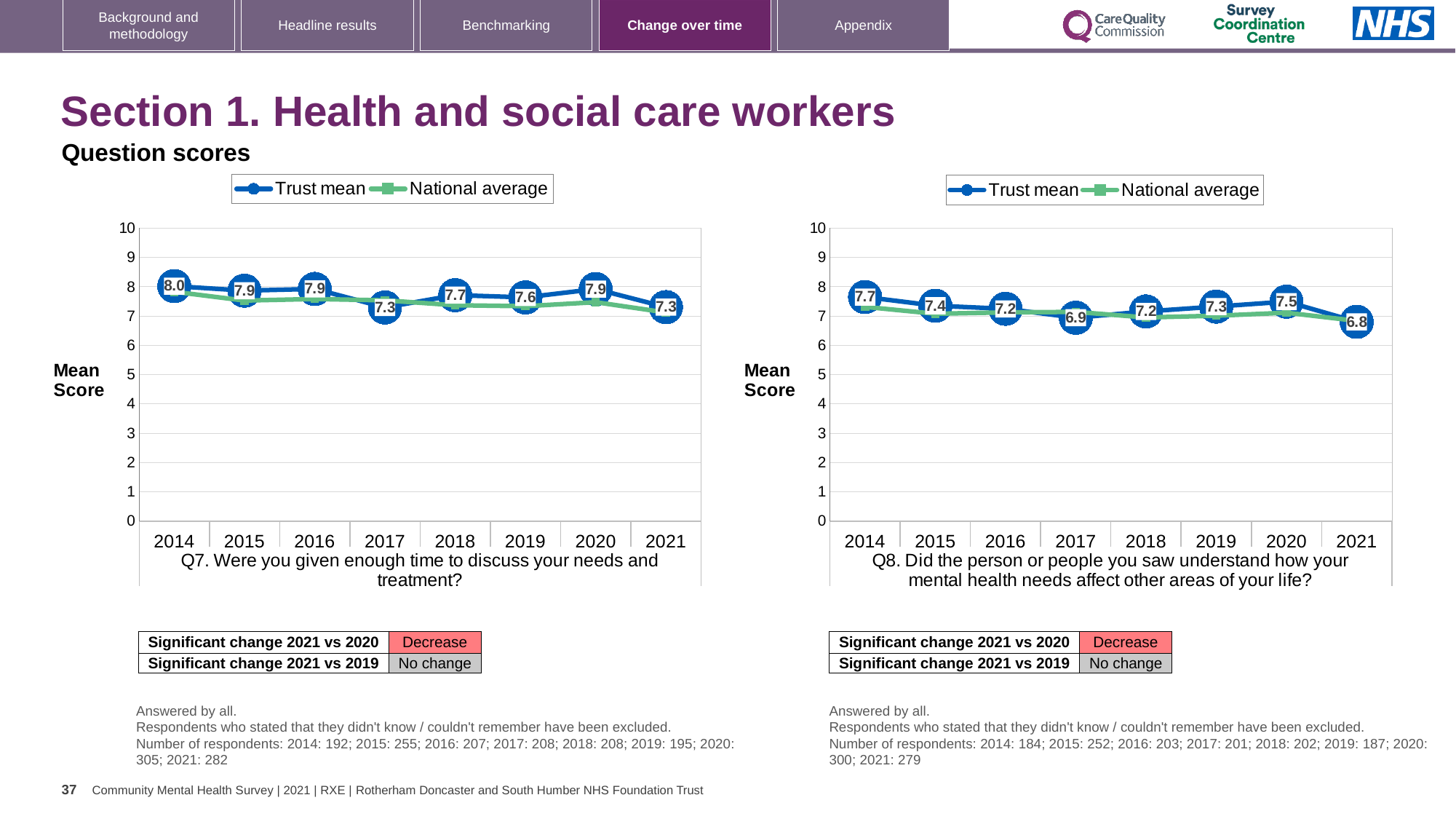
In the Q8 chart on the right, what is the Trust mean for 2021? 6.8 In the Q8 chart on the right, what is the difference between the Trust mean in 2014 and in 2021? 0.9 How many series does the legend of the Q8 chart on the right list? 2 In the Q7 chart on the left, which year has the highest Trust mean? 2014 In the Q8 chart on the right, what is the Trust mean for 2017? 6.9 How many years are plotted on the x axis of the Q7 chart on the left? 8 In the Q8 chart on the right, which year has the lowest Trust mean? 2021 What type of chart is the Q7 chart on the left? Line chart In the Q7 chart on the left, what is the Trust mean for 2014? 8.0 In the Q7 chart on the left, what is the difference between the Trust mean in 2020 and in 2021? 0.6 In the Q8 chart on the right, is the Trust mean higher in 2020 or in 2021? 2020 In the Q7 chart on the left, what is the Trust mean for 2021? 7.3